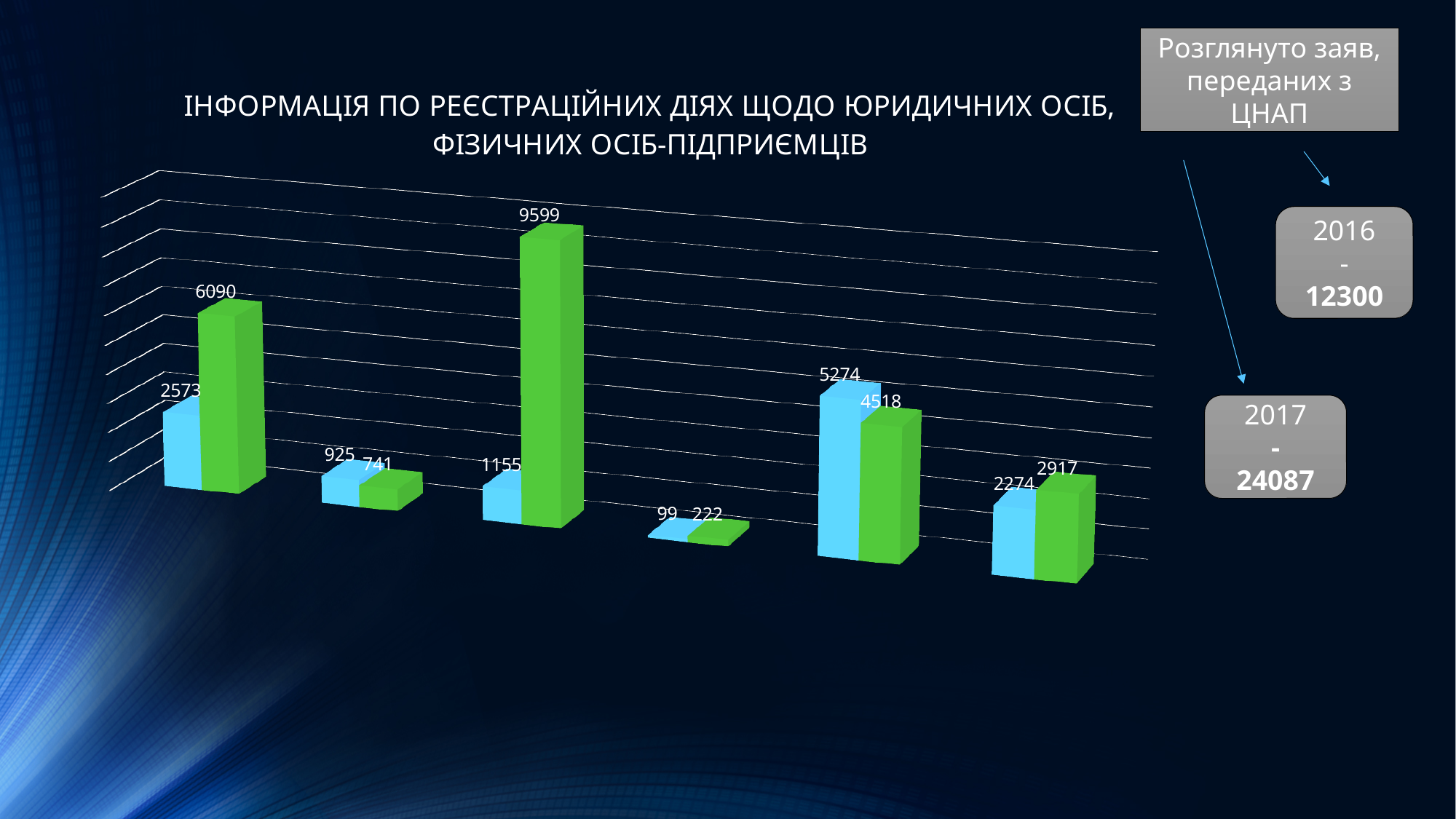
In the third group from the left, what is the difference between the green bar (9599) and the blue bar (1155)? 8444 What is the lowest value labelled on any bar in the chart? 99 What two colours are used for the bars in the chart? blue and green What is the value of the green bar in the fifth group from the left? 4518 How many bars are there in each group of the chart? 2 What is the highest value labelled on any bar in the chart? 9599 In the second group from the left, which bar is larger, the blue one or the green one? blue What is the value of the blue bar in the first (leftmost) group? 2573 In the first (leftmost) group, what is the difference between the green bar (6090) and the blue bar (2573)? 3517 How many groups of bars are plotted in the chart? 6 What kind of chart is shown on the slide? bar chart What is the value of the green bar in the sixth (rightmost) group? 2917